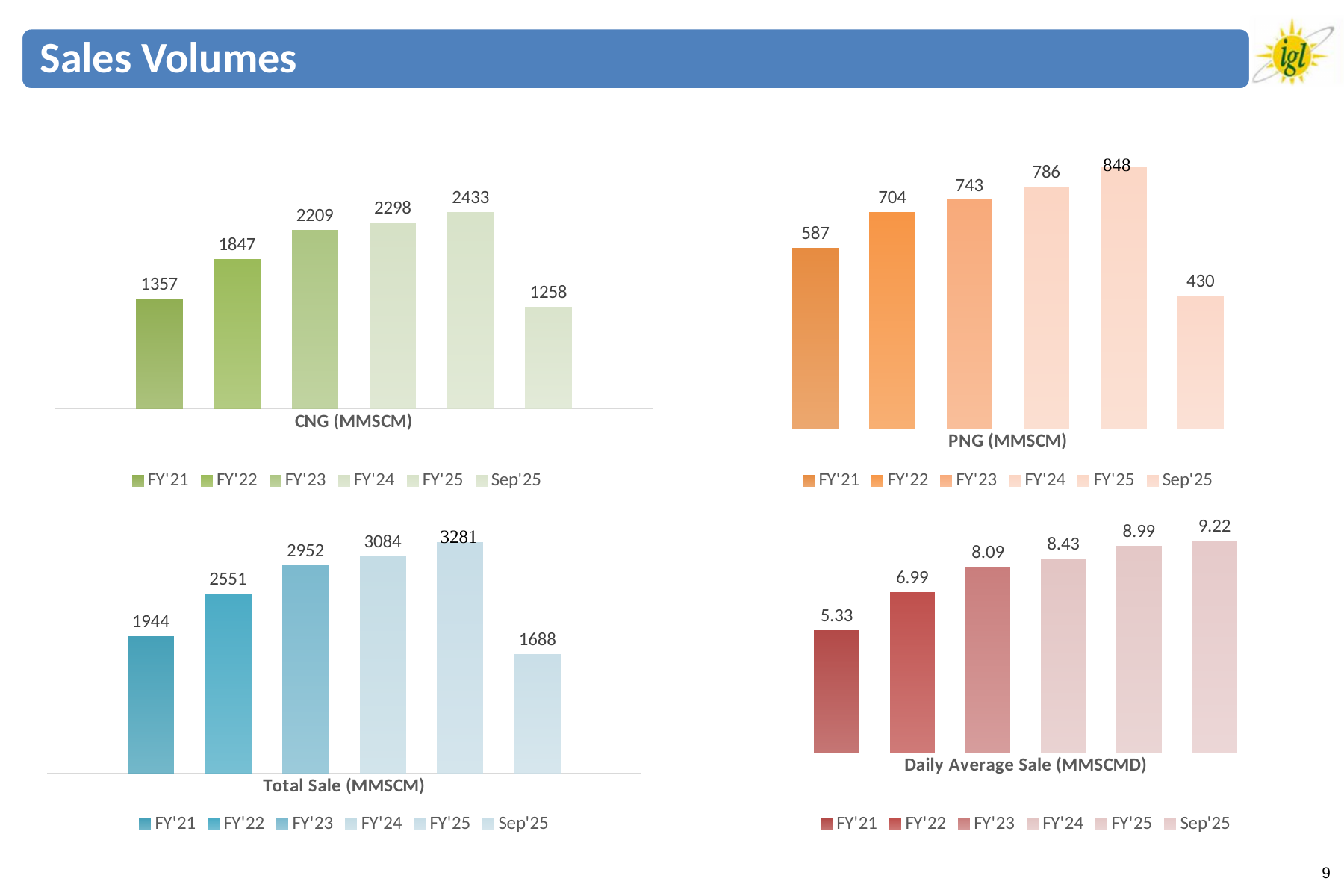
In the Daily Average Sale (MMSCMD) chart, do the values rise or fall from FY'21 to Sep'25? Rise In the Daily Average Sale (MMSCMD) chart, what is the value for FY'21? 5.33 How many bars are shown in the PNG (MMSCM) chart? 6 In the Total Sale (MMSCM) chart, which is larger, the value for FY'22 or the value for Sep'25? FY'22 In the Daily Average Sale (MMSCMD) chart, what is the difference between the Sep'25 and FY'25 values? 0.23 In the Total Sale (MMSCM) chart, which period has the lowest value? Sep'25 In the CNG (MMSCM) chart, what is the value for FY'25? 2433 In the PNG (MMSCM) chart, what is the value for Sep'25? 430 In the CNG (MMSCM) chart, what is the difference between the FY'25 and FY'21 values? 1076 In the PNG (MMSCM) chart, which period has the highest value? FY'25 In the Total Sale (MMSCM) chart, what is the value for FY'23? 2952 What kind of chart is the Daily Average Sale (MMSCMD) chart? Bar chart